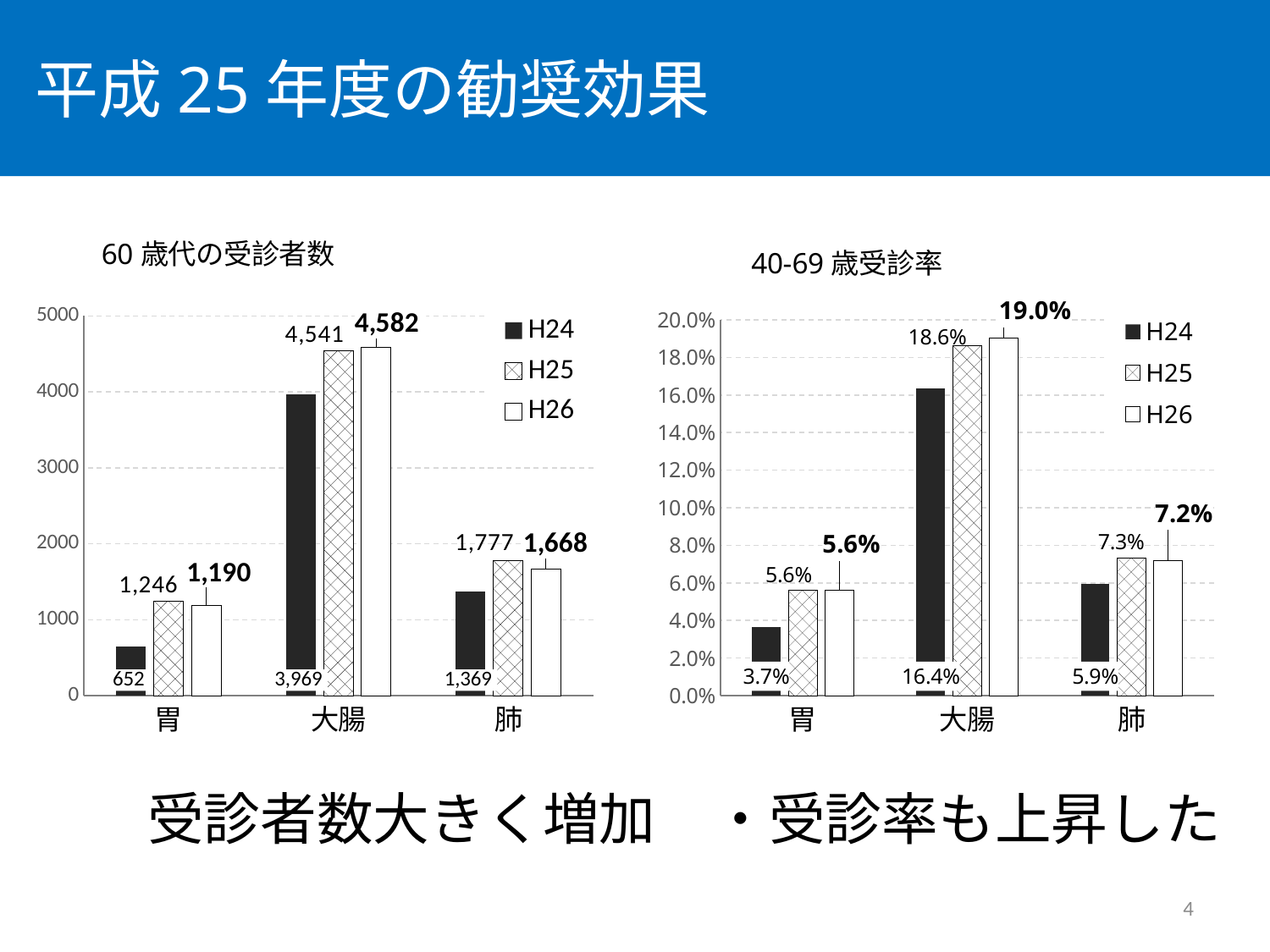
In the left chart (60歳代の受診者数), which category has the highest H26 value? 大腸 What kind of chart is the right chart (40-69歳受診率)? bar chart In the right chart (40-69歳受診率), what is the H26 value for 大腸? 19.0% In the right chart (40-69歳受診率), what is the difference between the H26 and H24 values for 大腸? 2.6% In the left chart (60歳代の受診者数), what is the H26 value for 胃? 1,190 How many series does the legend of the left chart (60歳代の受診者数) list? 3 In the right chart (40-69歳受診率), is the H24 value for 大腸 greater or less than 14.0%? greater In the left chart (60歳代の受診者数), which is larger for 肺: the H25 value or the H26 value? H25 In the left chart (60歳代の受診者数), what is the H24 value for 大腸? 3,969 In the right chart (40-69歳受診率), what is the H25 value for 肺? 7.3% In the left chart (60歳代の受診者数), what is the difference between the H25 and H24 values for 肺? 408 In the right chart (40-69歳受診率), which category has the lowest H24 value? 胃